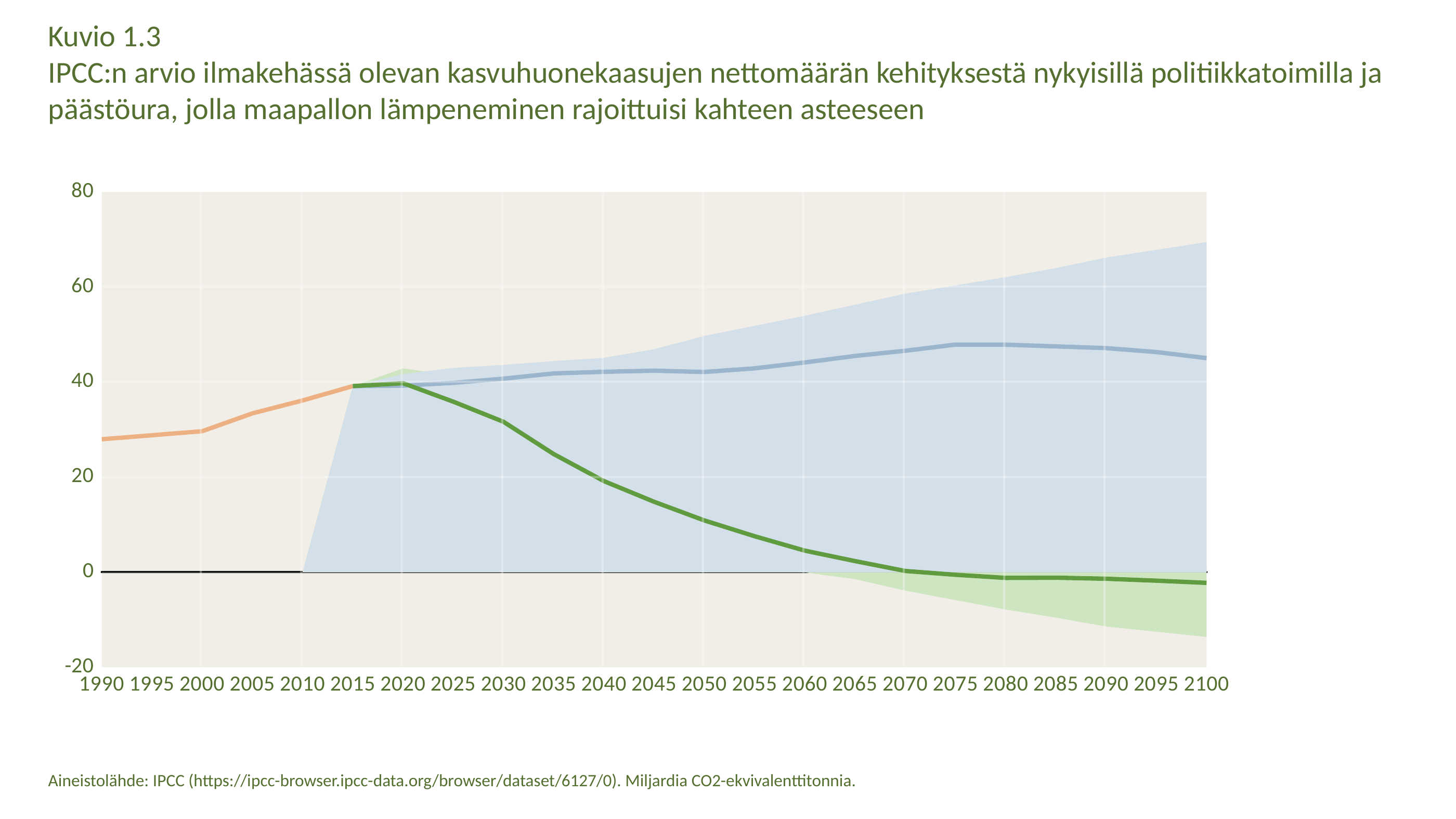
Is the value of the blue line in 2100 greater or less than 40? greater Does the orange line rise or fall between 1990 and 2015? rise How many year labels are shown on the x axis? 23 Is the value of the green line in 2030 greater or less than 40? less What unit is stated in the source note below the chart? Miljardia CO2-ekvivalenttitonnia Is the value of the green line in 2050 greater or less than 20? less In 2050, which line has the higher value, the blue line or the green line? the blue line What is the highest value shown on the y axis? 80 What kind of chart is shown on the slide? combination area and line chart Does the green line rise or fall between 2020 and 2100? fall